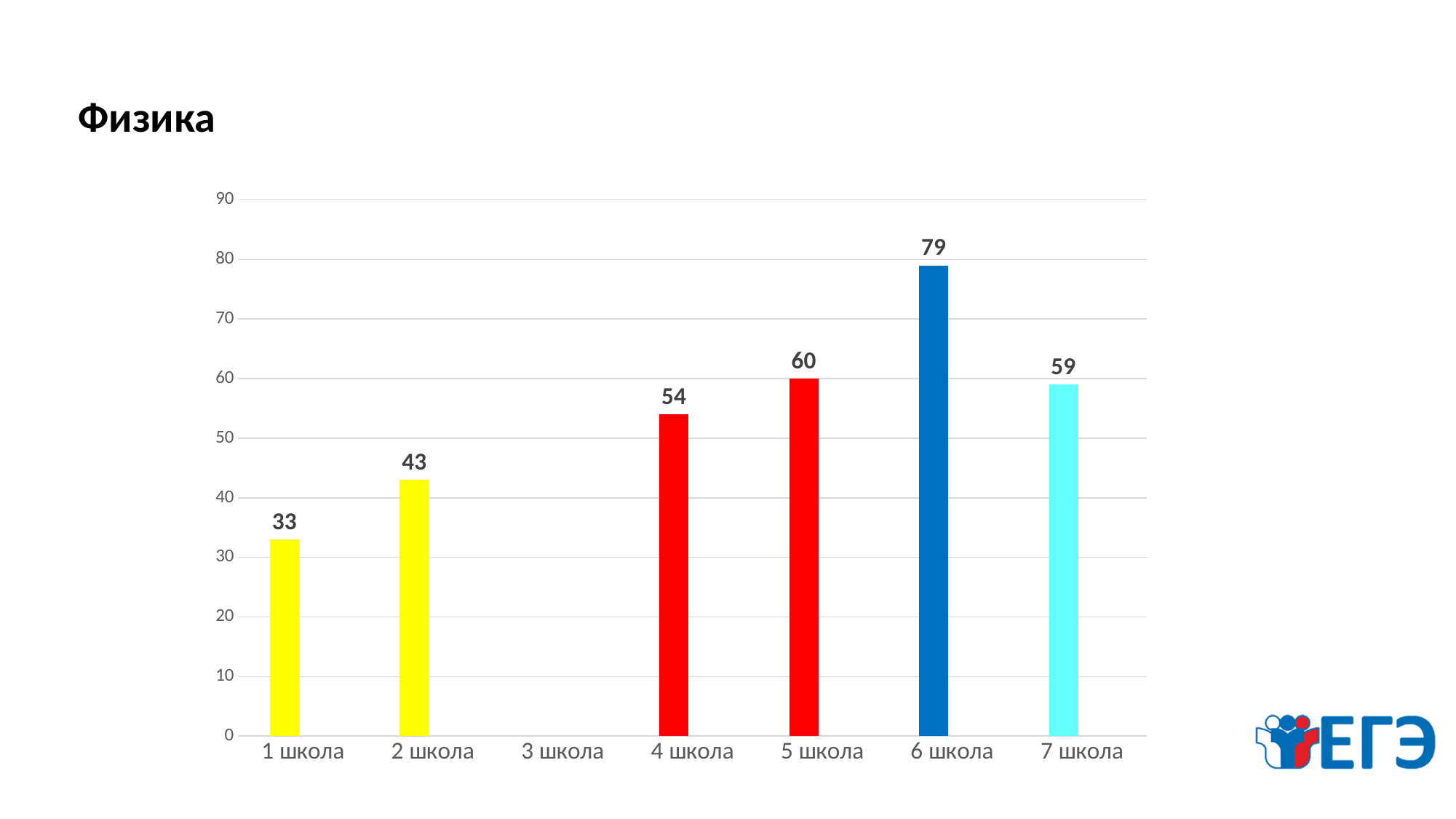
What is the difference between the values for 6 школа and 5 школа? 19 How many school categories are shown on the x axis? 7 What kind of chart is shown on the slide? bar chart What is the value for 4 школа? 54 What is the value for 1 школа? 33 Which school has the highest value? 6 школа What is the title of the slide? Физика Which is larger, the value for 5 школа or the value for 7 школа? 5 школа What is the value for 6 школа? 79 What is the difference between the values for 2 школа and 1 школа? 10 Is the value for 4 школа greater or less than 50? greater Which school with a visible bar has the lowest value? 1 школа